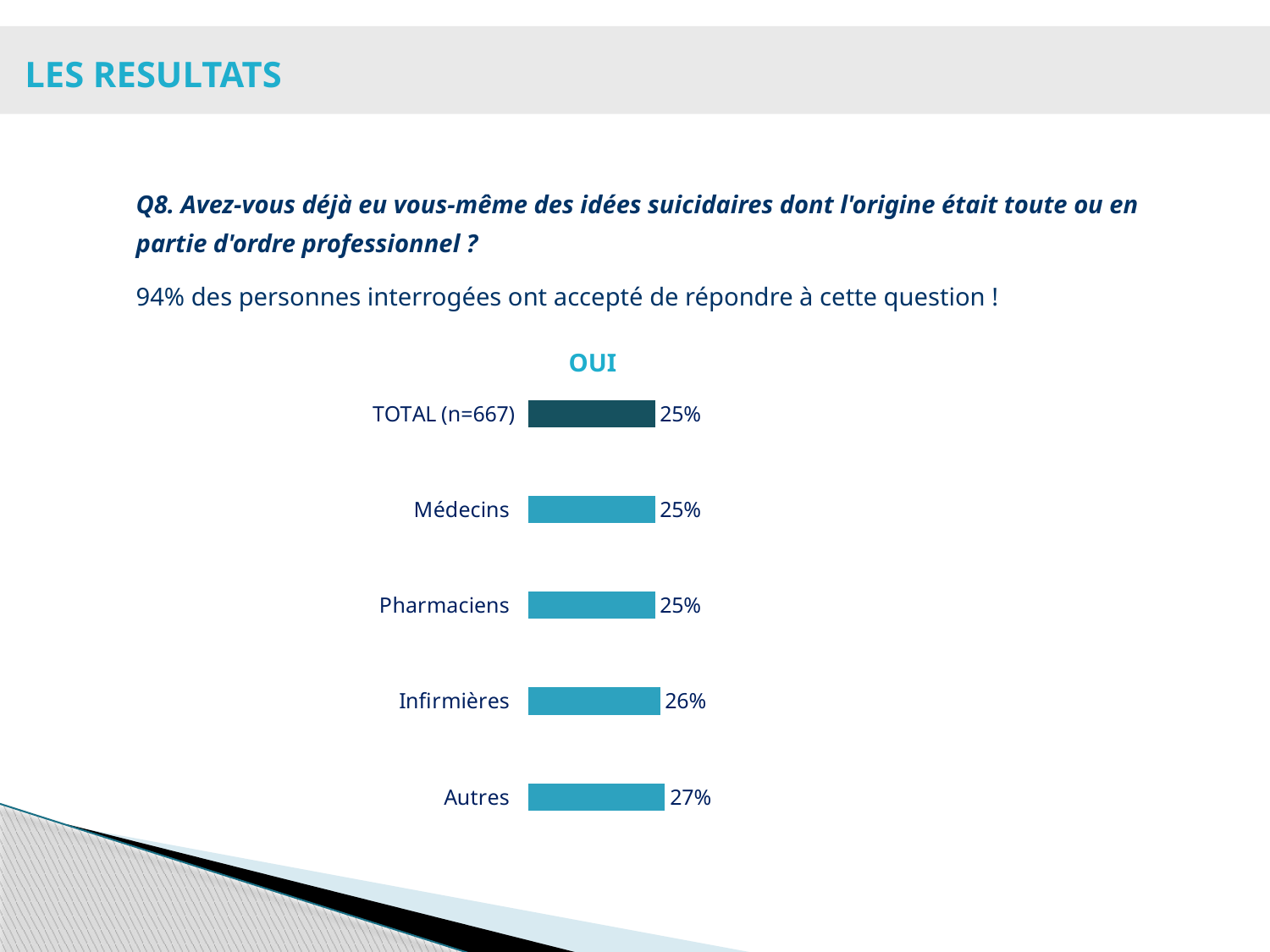
What is the value for Infirmières? 26% What is the title of the chart? OUI What is the value for TOTAL (n=667)? 25% How many categories are shown in the chart? 5 What is the difference between the values for Autres and Médecins? 2% What is the value for Autres? 27% Which category has the highest value? Autres What is the difference between the values for Infirmières and Pharmaciens? 1% What kind of chart is shown on the slide? bar chart Which is larger, the value for Autres or the value for Infirmières? Autres What is the value for Pharmaciens? 25% What is the value for Médecins? 25%